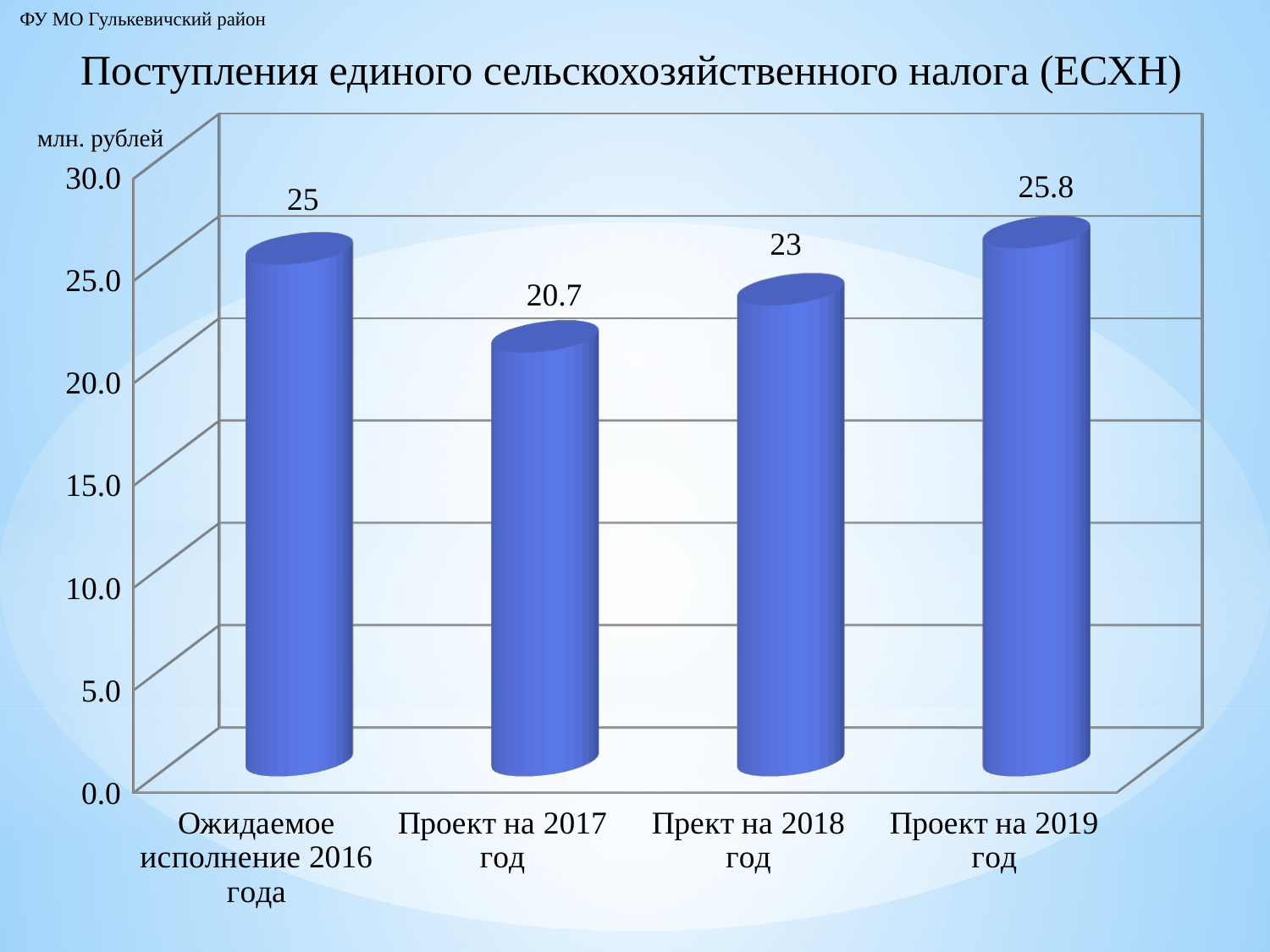
What is the difference between the values for 'Ожидаемое исполнение 2016 года' and 'Прект на 2018 год'? 2 What is the difference between the values for 'Проект на 2019 год' and 'Проект на 2017 год'? 5.1 Which category has the lowest value? Проект на 2017 год What kind of chart is shown on the slide? Bar chart What is the value for 'Ожидаемое исполнение 2016 года'? 25 Which is larger: the value for 'Ожидаемое исполнение 2016 года' or for 'Прект на 2018 год'? Ожидаемое исполнение 2016 года How many categories are shown on the chart? 4 What is the value for 'Прект на 2018 год'? 23 What is the value for 'Проект на 2017 год'? 20.7 What is the title of the chart? Поступления единого сельскохозяйственного налога (ЕСХН) Which category has the highest value? Проект на 2019 год What is the value for 'Проект на 2019 год'? 25.8